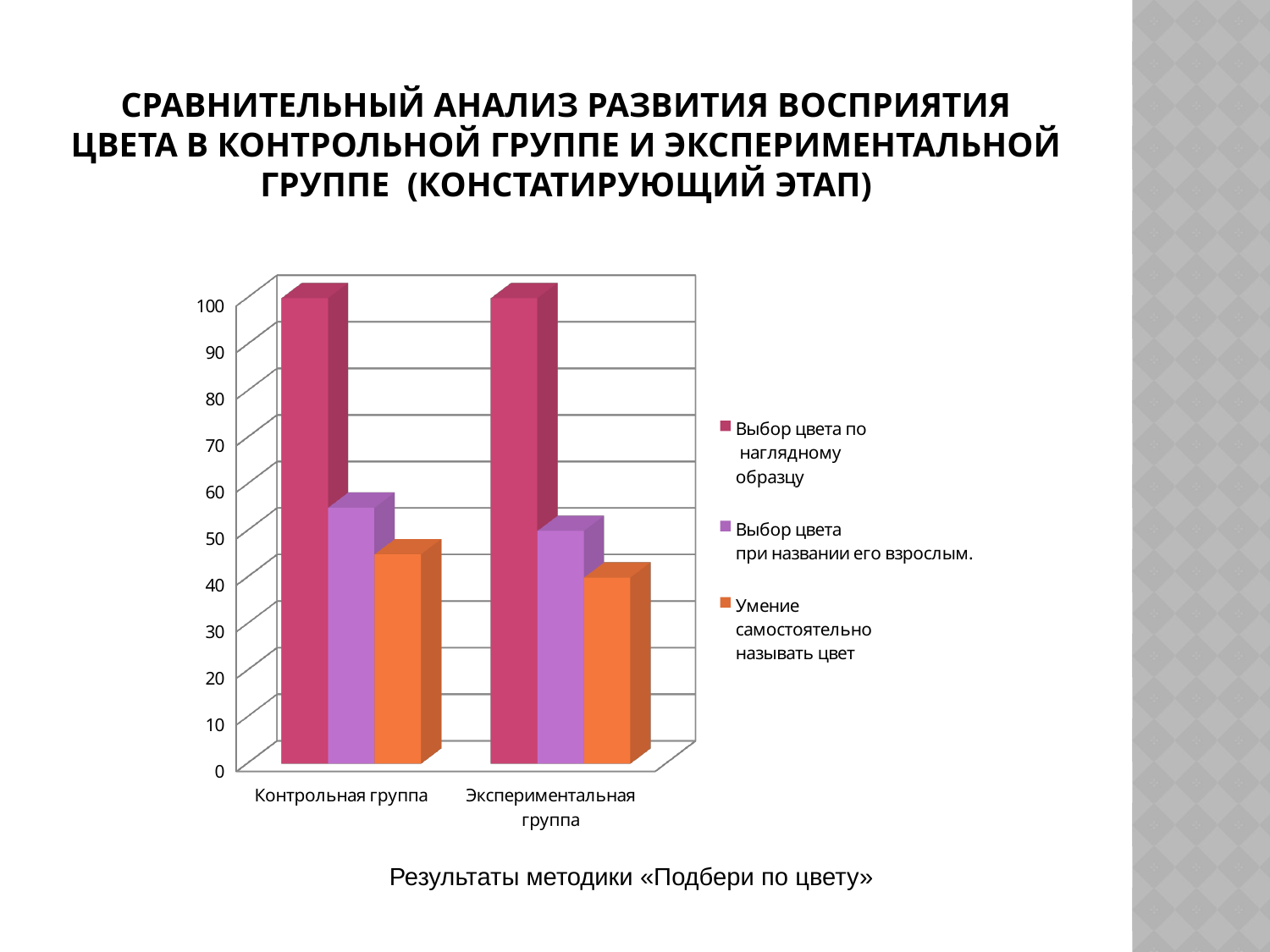
Is the value of 'Умение самостоятельно называть цвет' for Экспериментальная группа greater or less than 50? less Is the value of 'Выбор цвета при названии его взрослым' for Контрольная группа greater or less than 50? greater For Контрольная группа, which is larger: 'Выбор цвета при названии его взрослым' or 'Умение самостоятельно называть цвет'? Выбор цвета при названии его взрослым Is the value of 'Выбор цвета по наглядному образцу' for Контрольная группа greater or less than 90? greater Which series has the highest value for Контрольная группа? Выбор цвета по наглядному образцу What colour are the bars for the series 'Умение самостоятельно называть цвет'? Orange How many groups (categories) are shown on the x axis of the chart? 2 Which series has the lowest value for Экспериментальная группа? Умение самостоятельно называть цвет For 'Выбор цвета при названии его взрослым', which group has the larger value: Контрольная группа or Экспериментальная группа? Контрольная группа How many series does the chart legend list? 3 What kind of chart is shown on the slide? Bar chart